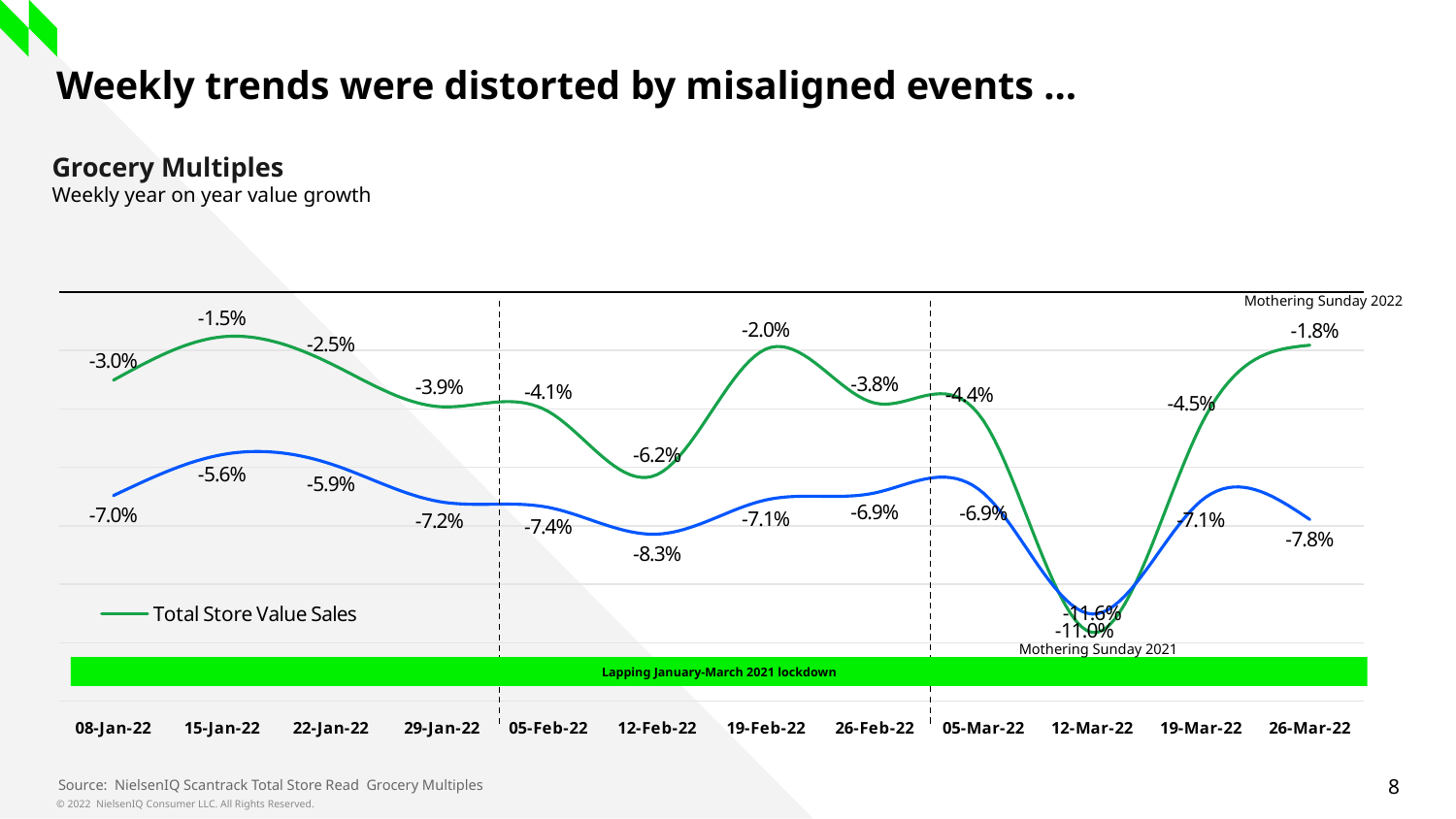
What text is written in the green band along the bottom of the chart? Lapping January-March 2021 lockdown What is the Total Store Value Sales growth for 15-Jan-22? -1.5% How many weekly dates are shown on the x axis? 12 What is the Total Store Value Sales growth for 12-Feb-22? -6.2% Which date has the higher Total Store Value Sales growth, 15-Jan-22 or 22-Jan-22? 15-Jan-22 On which date does the Total Store Value Sales line reach its lowest value? 12-Mar-22 What is the Total Store Value Sales growth for 26-Mar-22? -1.8% What is the difference in Total Store Value Sales growth between 19-Feb-22 (-2.0%) and 12-Feb-22 (-6.2%)? 4.2 percentage points On which date does the Total Store Value Sales line reach its highest value? 15-Jan-22 What type of chart is shown on the slide? Line chart What value does the blue line show for 12-Feb-22? -8.3% What value does the blue line show for 08-Jan-22? -7.0%